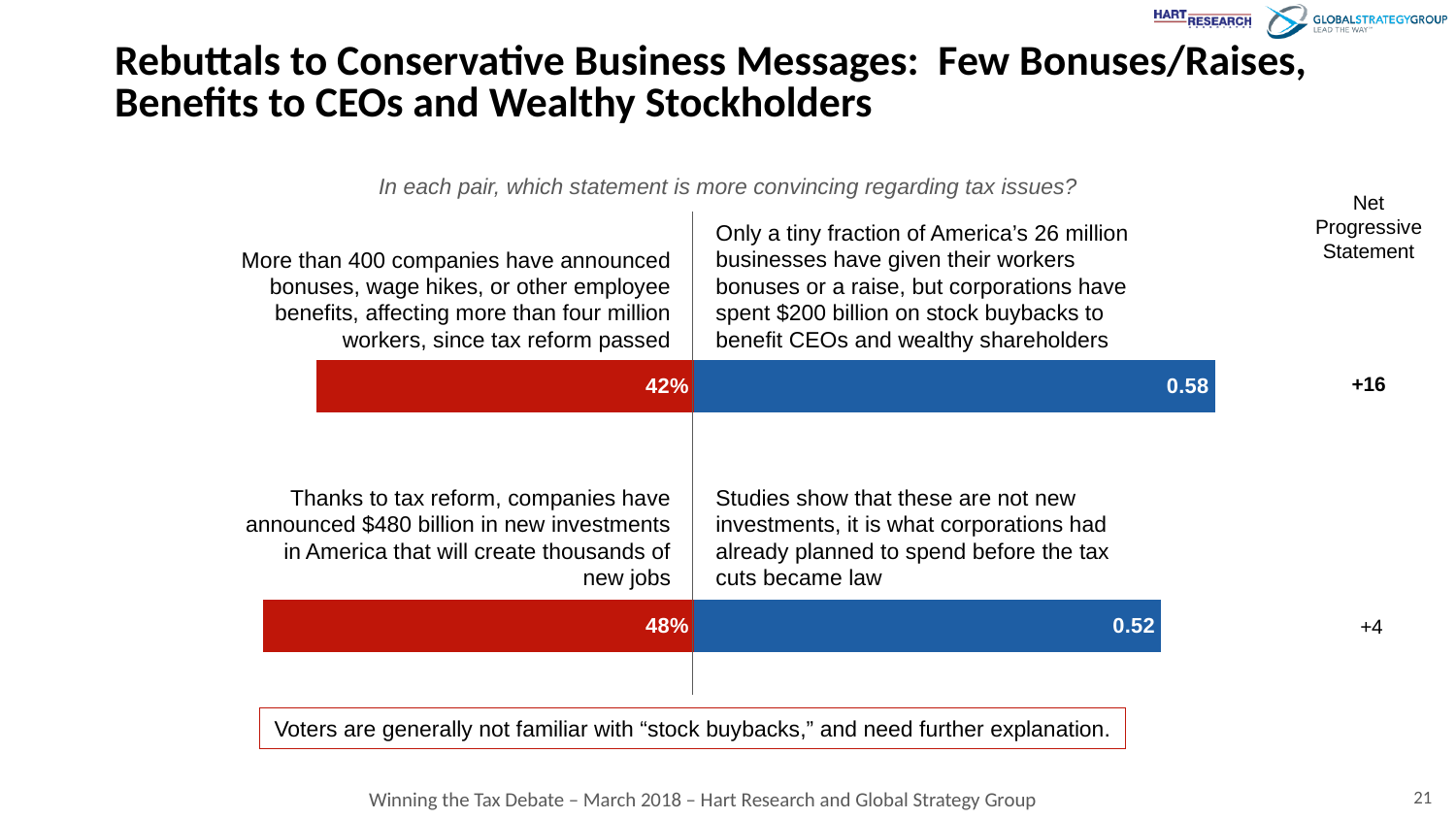
What colour are the bars representing the conservative business statements? Red In the first pair, which statement was found more convincing: the conservative statement about 400 companies announcing bonuses, or the progressive statement about stock buybacks? The progressive statement about stock buybacks How many pairs of statements are compared on the chart? 2 What kind of chart is shown on the slide? Bar chart What percentage is shown for the statement 'Thanks to tax reform, companies have announced $480 billion in new investments...'? 48% What is the Net Progressive Statement value for the first pair (bonuses vs. stock buybacks)? +16 What is the Net Progressive Statement value for the second pair (new investments)? +4 Which pair has the larger Net Progressive Statement value? The first pair (bonuses vs. stock buybacks), +16 What value is shown on the blue bar for the statement about corporations spending $200 billion on stock buybacks? 0.58 What percentage of respondents found the statement 'More than 400 companies have announced bonuses, wage hikes, or other employee benefits...' more convincing? 42% What value is shown on the blue bar for the statement 'Studies show that these are not new investments...'? 0.52 What is the difference between the two red-bar percentages (48% and 42%)? 6 percentage points